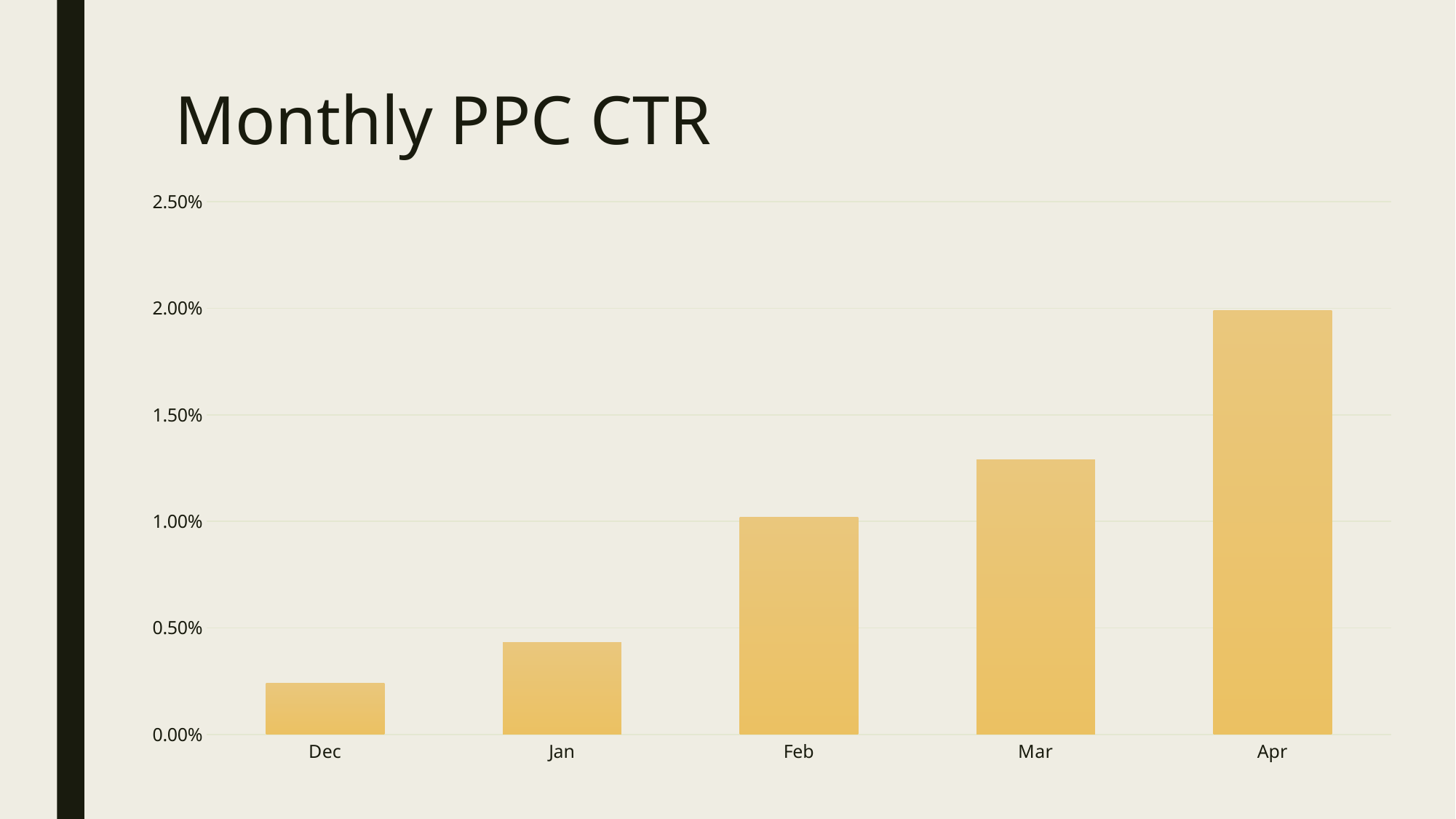
Which month has the lowest CTR? Dec Is the value for Mar greater or less than 1.00%? greater How many months are shown on the x axis of the chart? 5 Is the value for Feb greater or less than 1.50%? less What type of chart is shown on the slide? bar chart Which month has the larger CTR, Dec or Jan? Jan Which month has the highest CTR? Apr Is the value for Dec greater or less than 0.50%? less Which month has the larger CTR, Feb or Mar? Mar Do the CTR values rise or fall from Dec to Apr? rise What is the title of the chart? Monthly PPC CTR